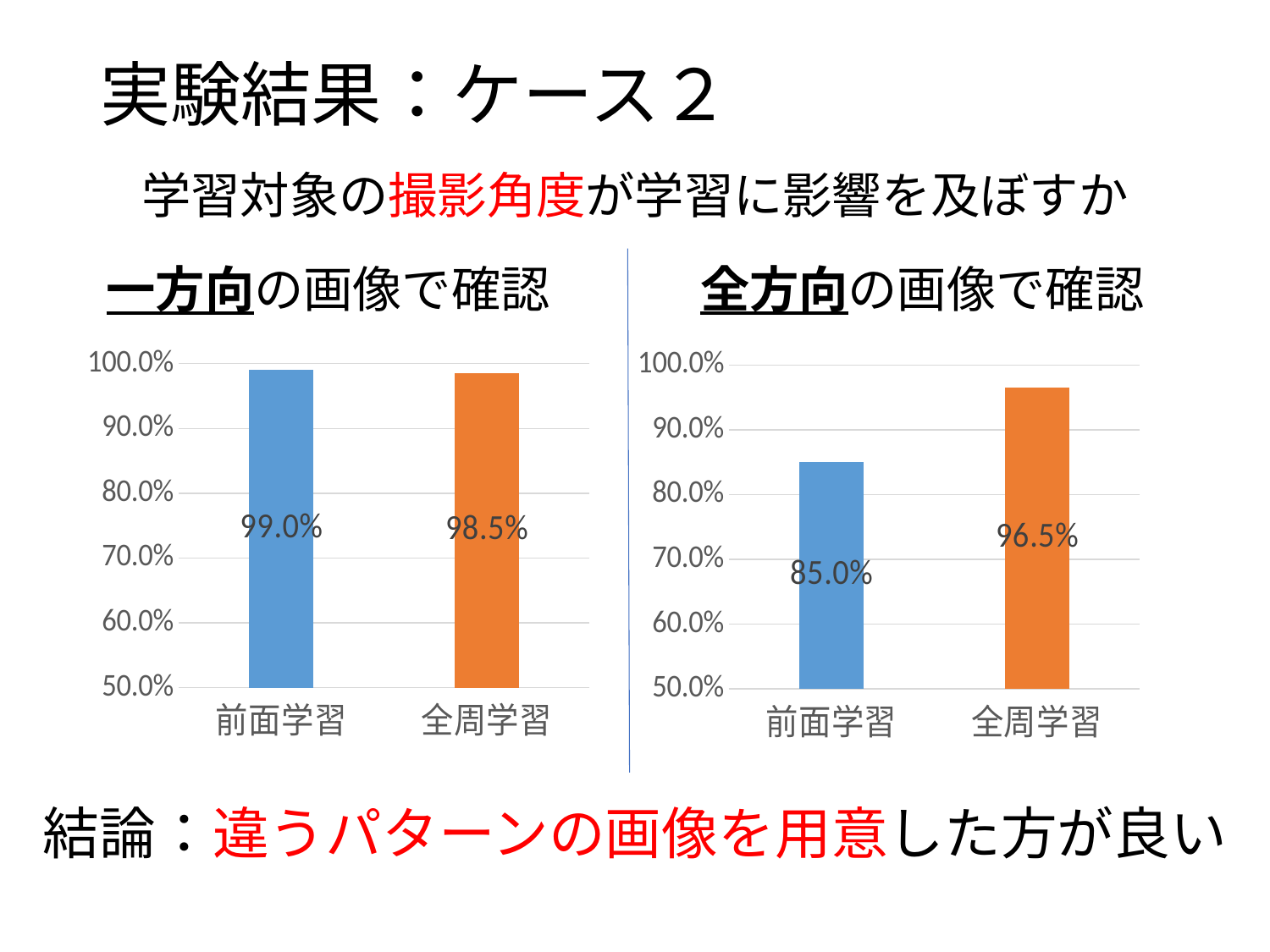
In the right chart (全方向の画像で確認), what is the value for 全周学習? 96.5% In the right chart (全方向の画像で確認), is the value for 前面学習 greater or less than 90.0%? less In the left chart (一方向の画像で確認), what colour is the bar for 全周学習? orange In the left chart (一方向の画像で確認), what is the value for 前面学習? 99.0% What kind of chart is the right chart (全方向の画像で確認)? bar chart In the right chart (全方向の画像で確認), what is the difference between 全周学習 and 前面学習? 11.5% In the right chart (全方向の画像で確認), what is the value for 前面学習? 85.0% In the right chart (全方向の画像で確認), which category has the highest value? 全周学習 In the right chart (全方向の画像で確認), which category has the lowest value? 前面学習 In the left chart (一方向の画像で確認), what is the value for 全周学習? 98.5% How many categories does the left chart (一方向の画像で確認) show? 2 In the left chart (一方向の画像で確認), what is the difference between 前面学習 and 全周学習? 0.5%